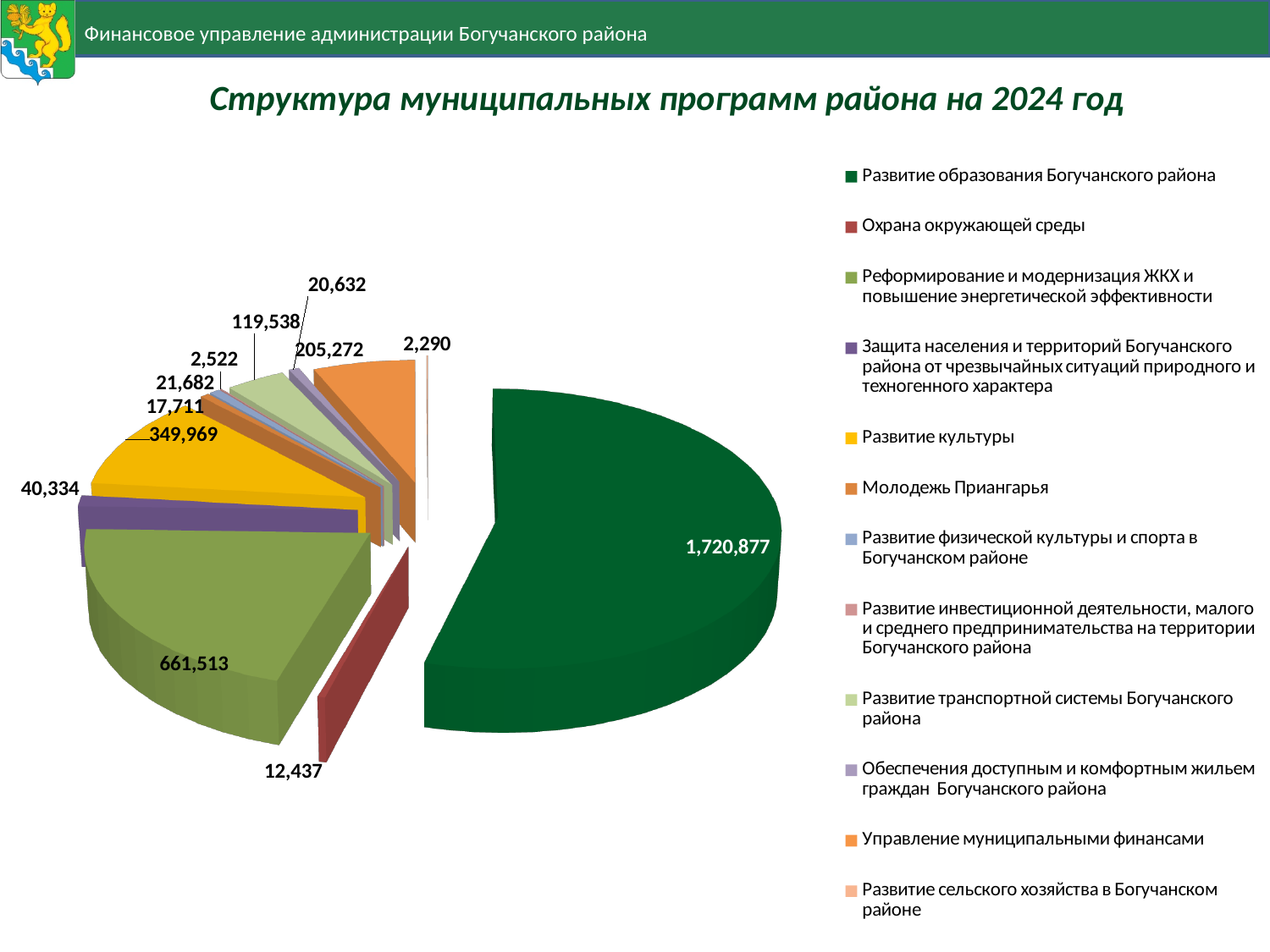
What is the value shown for Развитие культуры? 349,969 What is the value shown for Реформирование и модернизация ЖКХ и повышение энергетической эффективности? 661,513 What is the difference between the values for Развитие образования Богучанского района and Реформирование и модернизация ЖКХ и повышение энергетической эффективности? 1,059,364 What is the value shown for Управление муниципальными финансами? 205,272 What is the value shown for Развитие образования Богучанского района? 1,720,877 What type of chart is shown on the slide? pie chart Which is larger: the value for Развитие культуры or the value for Управление муниципальными финансами? Развитие культуры How many categories does the legend of the pie chart list? 12 What is the value shown for Охрана окружающей среды? 12,437 Which category has the smallest value in the pie chart? Развитие сельского хозяйства в Богучанском районе Which category has the largest slice of the pie? Развитие образования Богучанского района What is the title of the chart on the slide? Структура муниципальных программ района на 2024 год